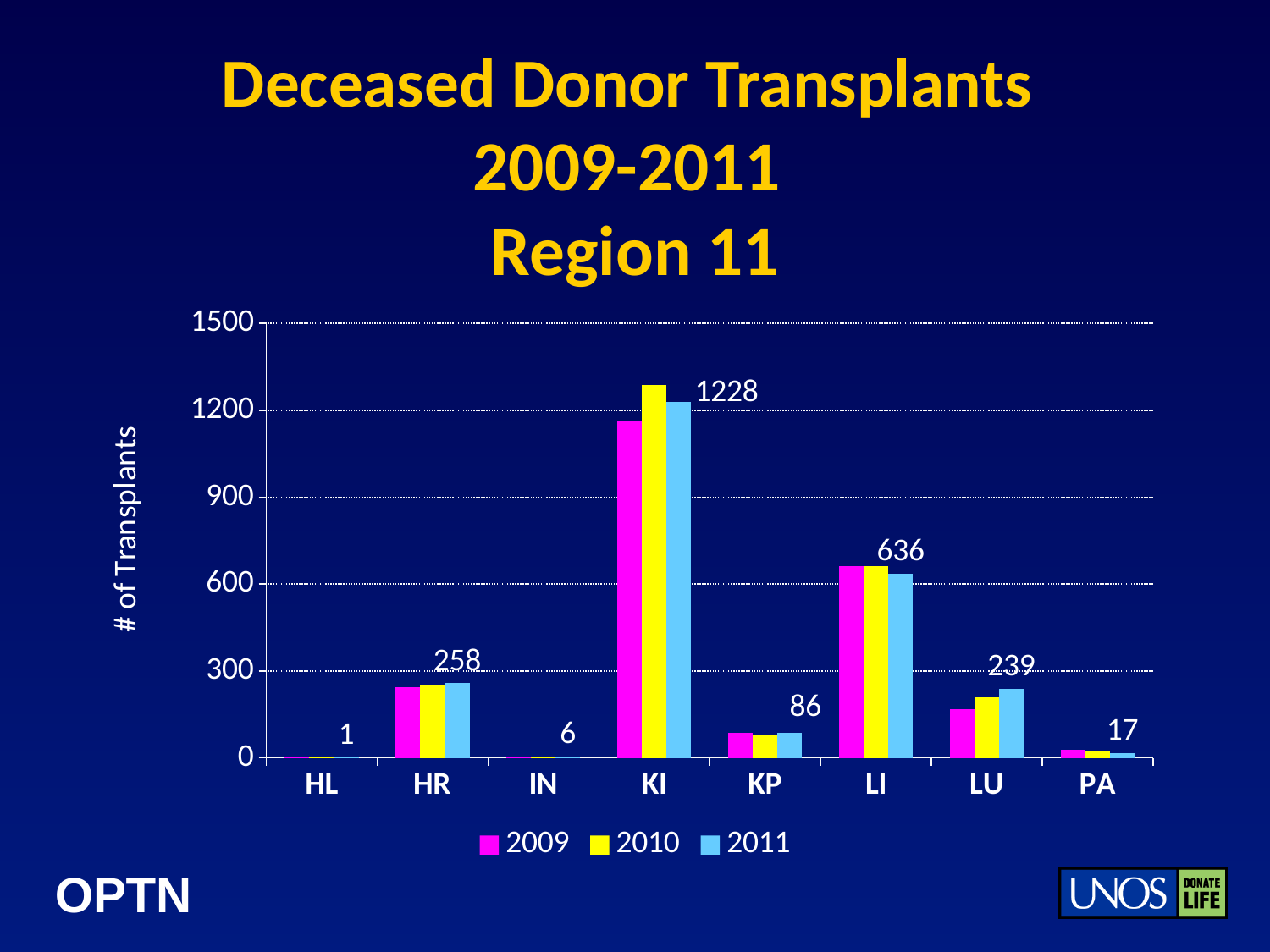
How many series does the legend list? 3 In 2011, which has more transplants, HR or LU? HR What is the difference between the 2011 values for KI and LI? 592 Which organ category has the highest number of transplants in 2011? KI What is the 2011 value for PA? 17 How many organ categories are shown on the x axis? 8 Is the 2010 value for KI greater or less than 1200? greater What is the 2011 value for LI? 636 What is the 2011 value for HR? 258 Which organ category has the lowest number of transplants in 2011? HL What is the number of deceased donor transplants for KI in 2011? 1228 What type of chart is shown on the slide? bar chart